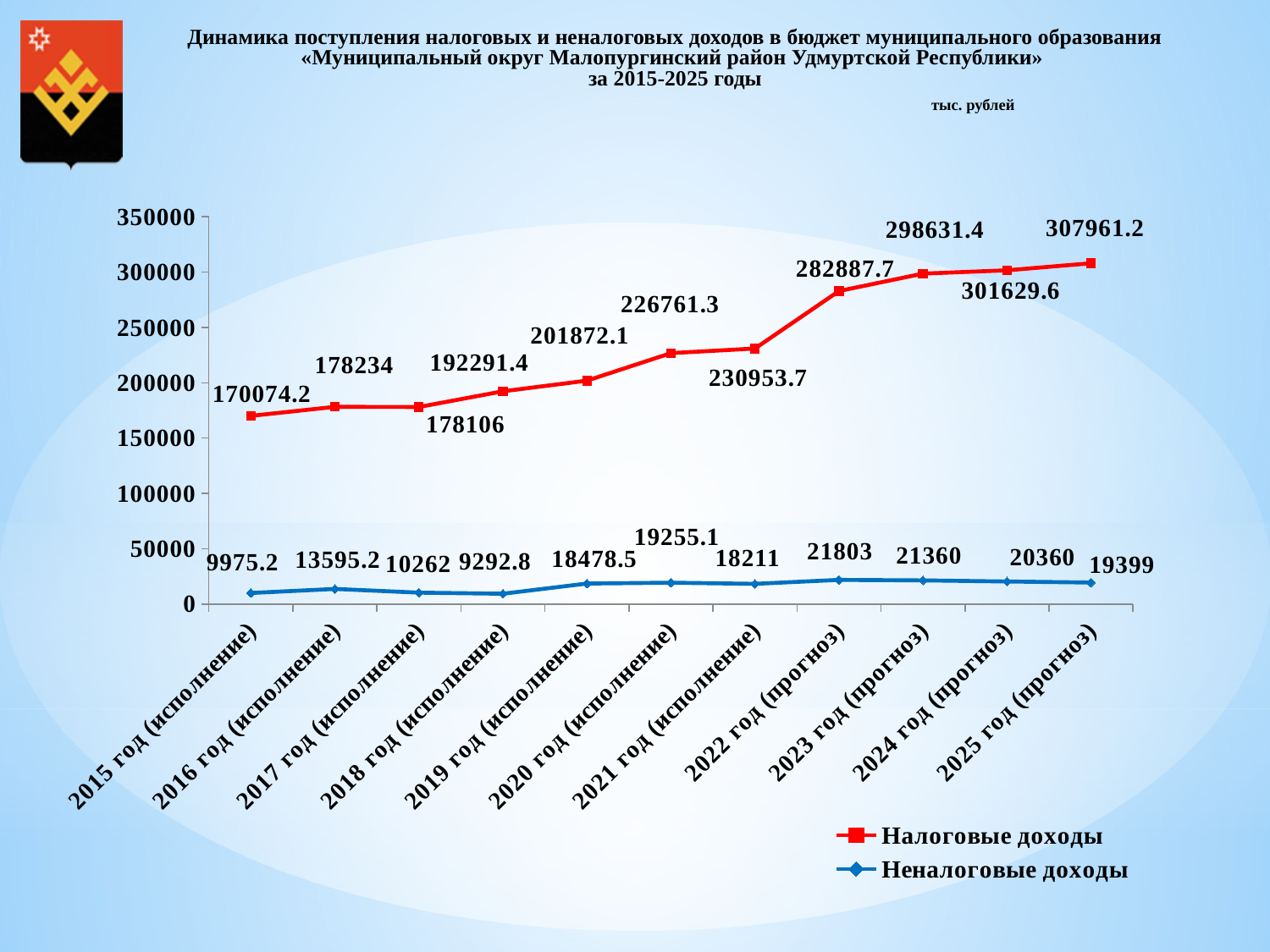
Which year has the larger value of Неналоговые доходы: 2016 год (исполнение) or 2017 год (исполнение)? 2016 год (исполнение) How many series does the legend list? 2 What is the difference between Неналоговые доходы in 2023 год (прогноз) and 2024 год (прогноз)? 1000 What is the difference between Налоговые доходы in 2025 год (прогноз) and 2015 год (исполнение)? 137887 In which year is the value of Неналоговые доходы the lowest? 2018 год (исполнение) What is the value of Налоговые доходы for 2015 год (исполнение)? 170074.2 What is the value of Неналоговые доходы for 2022 год (прогноз)? 21803 Is the value of Налоговые доходы for 2021 год (исполнение) greater or less than 250000? less In which year is the value of Налоговые доходы the highest? 2025 год (прогноз) What kind of chart is shown on the slide? line chart In which year is the value of Неналоговые доходы the highest? 2022 год (прогноз) How many years are shown on the x axis of the chart? 11